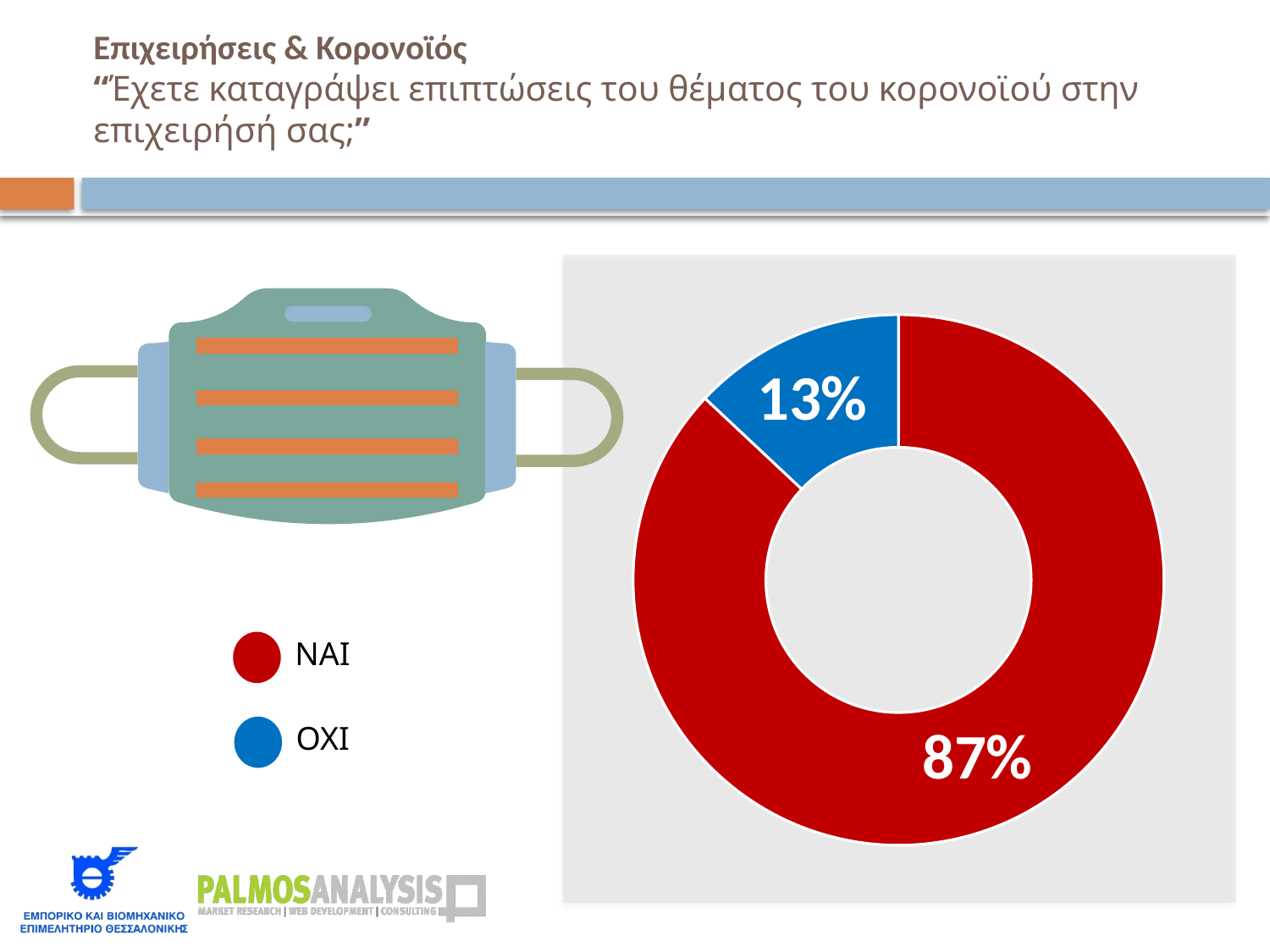
How many categories are shown in the chart? 2 What is the total of the two percentages shown in the chart? 100% What percentage of the doughnut chart corresponds to ΟΧΙ? 13% What percentage of the doughnut chart corresponds to ΝΑΙ? 87% How many entries does the legend list? 2 What is the difference in percentage points between ΝΑΙ and ΟΧΙ? 74 Which is larger, the share for ΝΑΙ or the share for ΟΧΙ? ΝΑΙ What kind of chart is shown on the slide? Doughnut (pie) chart What colour represents ΟΧΙ in the chart? Blue Which category has the largest share in the chart? ΝΑΙ What colour represents ΝΑΙ in the chart? Red Which category has the smallest share in the chart? ΟΧΙ